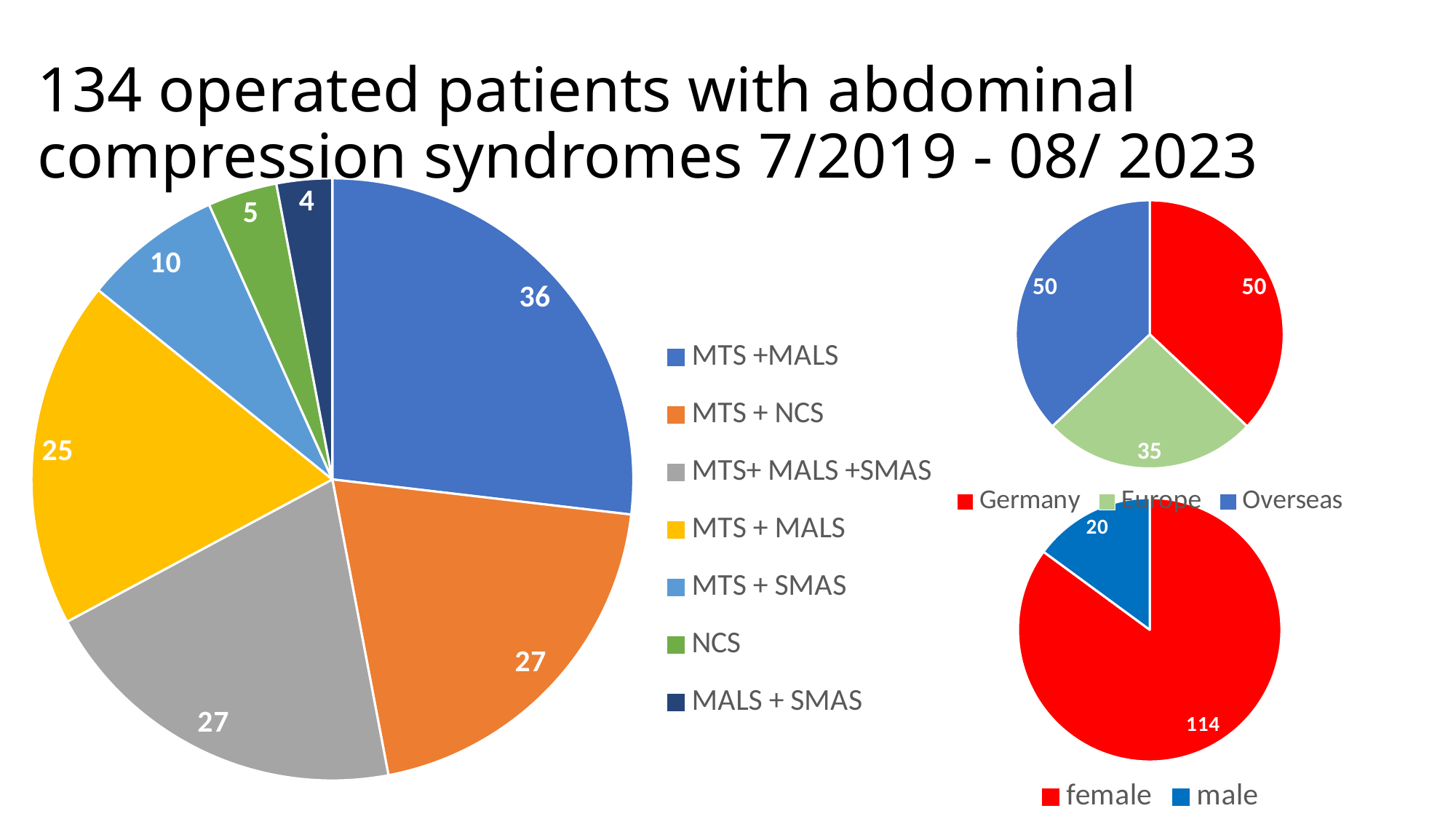
In the top-right pie chart (Germany, Europe, Overseas), what is the total of all slices? 135 In the large pie chart on the left, what is the value for MTS + SMAS? 10 In the bottom-right pie chart (female, male), what is the difference between the female and male values? 94 In the top-right pie chart (Germany, Europe, Overseas), what is the value for Europe? 35 In the large pie chart on the left, what is the value for NCS? 5 In the large pie chart on the left, what is the value for MTS + NCS? 27 In the top-right pie chart (Germany, Europe, Overseas), which is larger, Germany or Europe? Germany In the large pie chart on the left, how many categories does the legend list? 7 In the bottom-right pie chart (female, male), what is the value for male? 20 In the large pie chart on the left, what is the difference between the values for MTS + NCS and MTS + SMAS? 17 In the large pie chart on the left, which category has the smallest value? MALS + SMAS What kind of chart is the bottom-right chart (female, male)? pie chart